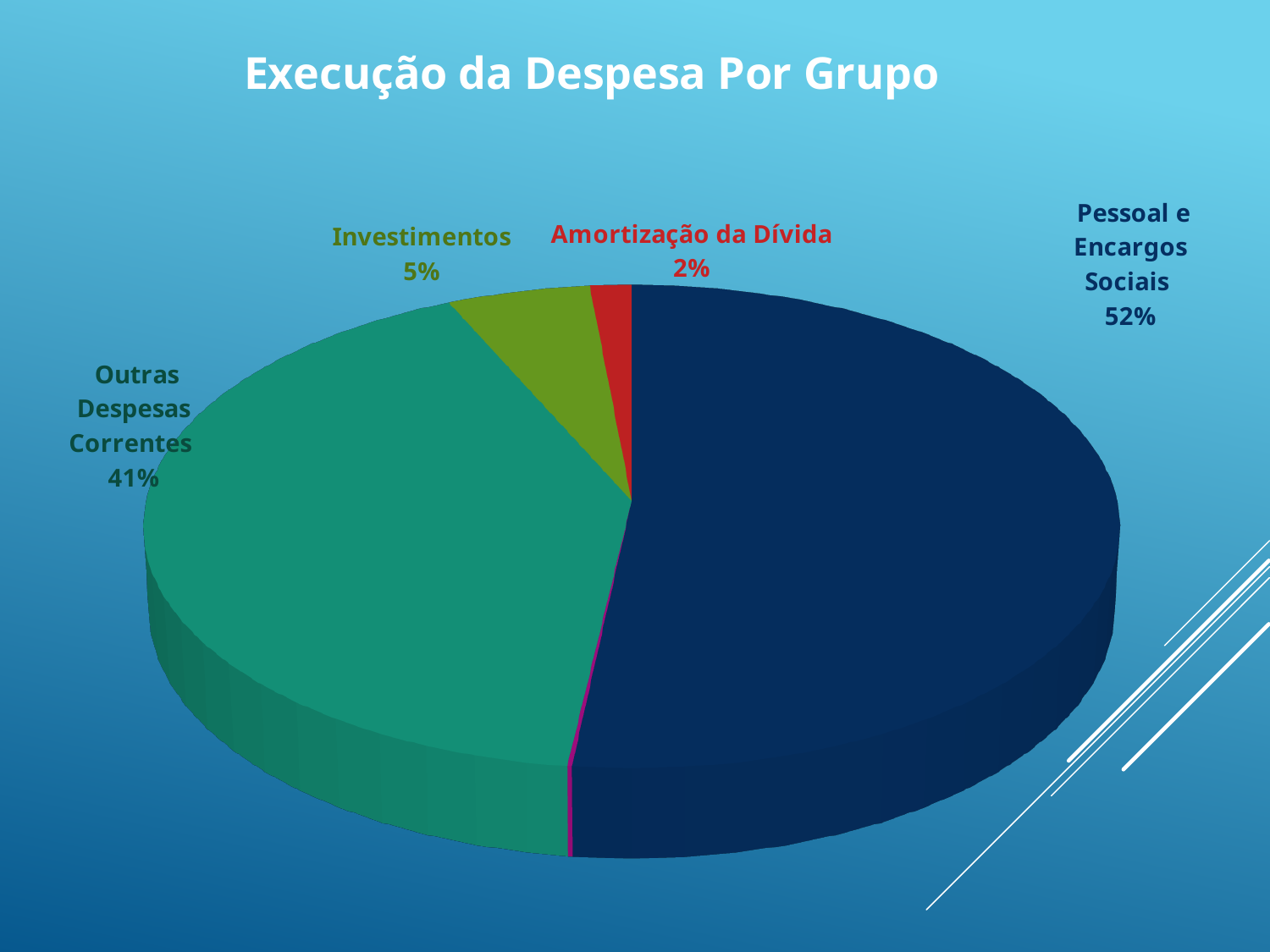
What is the value shown for Investimentos? 5% What is the value shown for Amortização da Dívida? 2% Which is larger, Investimentos or Amortização da Dívida? Investimentos Which category has the largest slice of the pie? Pessoal e Encargos Sociais What share of the pie does Pessoal e Encargos Sociais represent? 52% What is the difference in percentage points between Pessoal e Encargos Sociais and Outras Despesas Correntes? 11 How many categories are shown in the pie chart? 4 What colour is the slice for Amortização da Dívida? Red What kind of chart is shown on the slide? Pie chart What share of the pie does Outras Despesas Correntes represent? 41% What is the title of the chart? Execução da Despesa Por Grupo